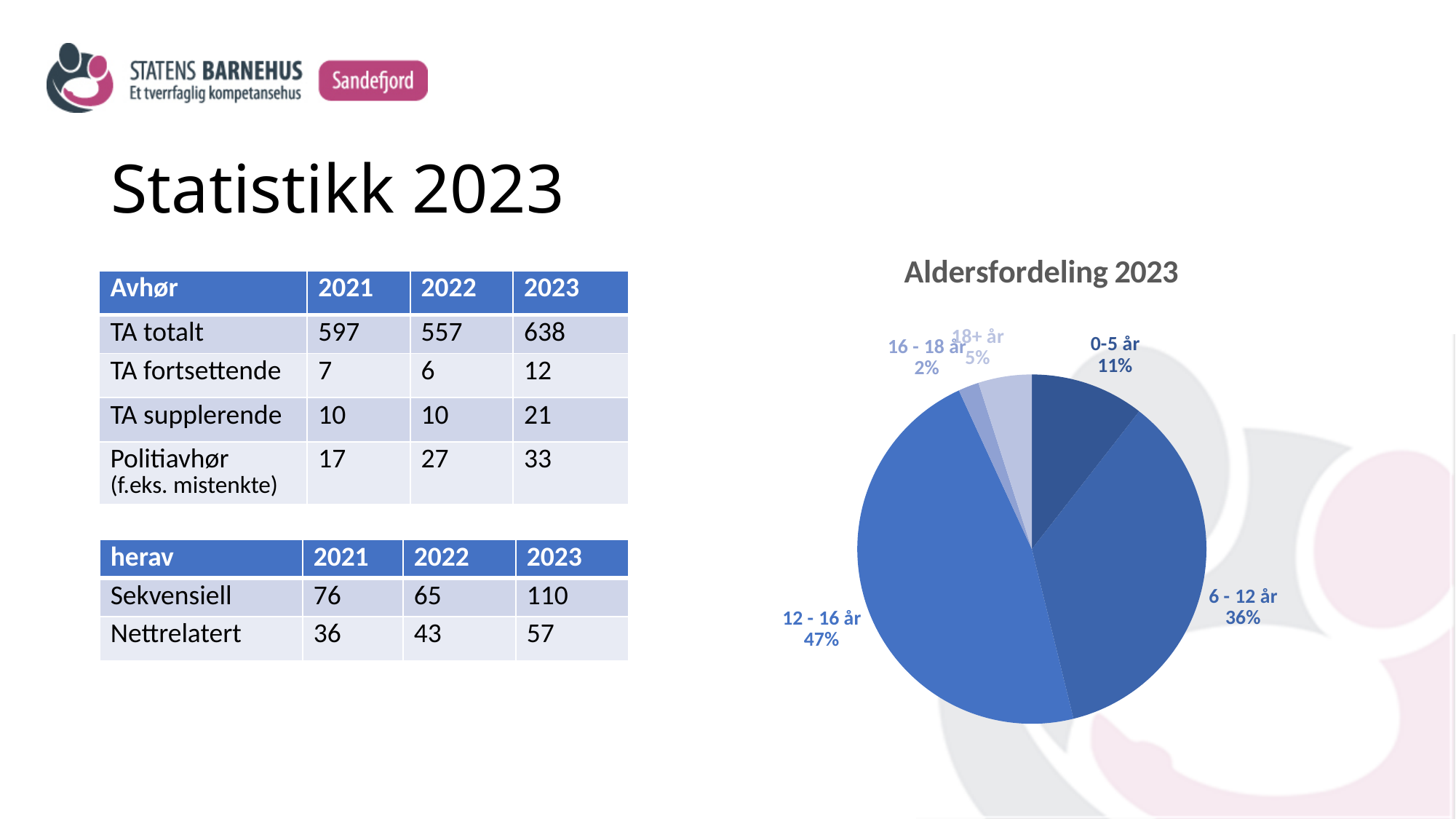
What share of the pie does the 0-5 år slice represent? 11% Which age group has the largest share of the pie? 12 - 16 år What kind of chart is shown on the slide? pie chart Which age group has the smallest share of the pie? 16 - 18 år What share of the pie does the 12 - 16 år slice represent? 47% What share of the pie does the 18+ år slice represent? 5% What is the title of the chart on the slide? Aldersfordeling 2023 How many slices does the pie chart have? 5 Which slice is larger, 0-5 år or 18+ år? 0-5 år What is the difference in percentage points between the 12 - 16 år slice and the 6 - 12 år slice? 11